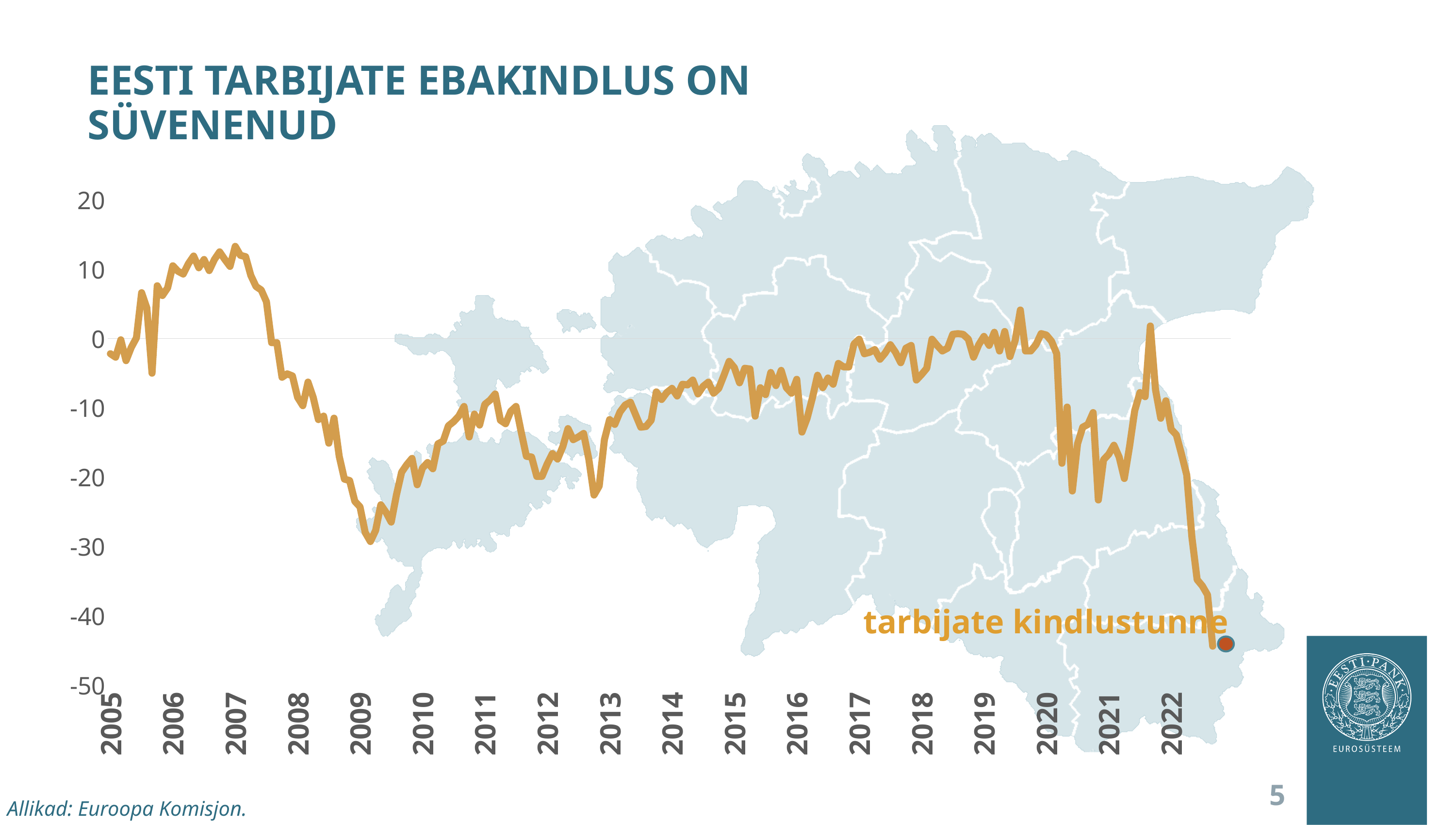
What is the name of the series plotted on the chart? tarbijate kindlustunne Is the value at the end of 2022 greater or less than -40? less Is the peak value in 2007 greater or less than 10? greater In which year does the line reach its highest value? 2007 What kind of chart is shown on the slide? line chart Does the line rise or fall between 2007 and 2009? fall Is the lowest value in 2009 greater or less than -20? less What is the title of the slide containing the chart? EESTI TARBIJATE EBAKINDLUS ON SÜVENENUD In which year does the line reach its lowest value? 2022 Does the line rise or fall between 2019 and the end of 2022? fall How many year labels are shown on the x axis of the chart? 18